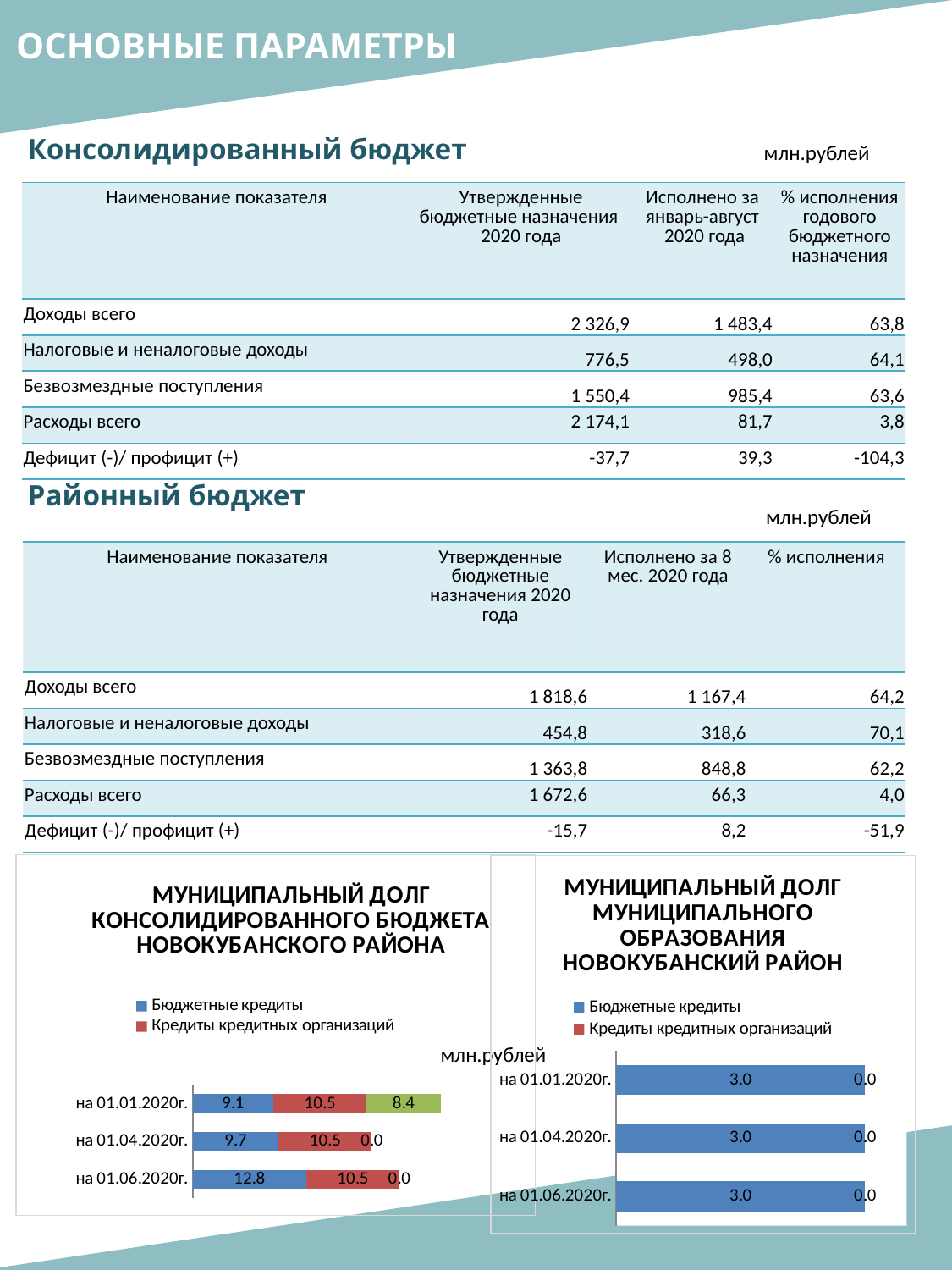
In the left chart (Муниципальный долг консолидированного бюджета Новокубанского района), what is the total of the stacked bar for на 01.06.2020г.? 23.3 In the right chart (Муниципальный долг муниципального образования Новокубанский район), what is the value of Бюджетные кредиты на 01.04.2020г.? 3.0 In the right chart (Муниципальный долг муниципального образования Новокубанский район), how many series does the legend list? 2 In the left chart (Муниципальный долг консолидированного бюджета Новокубанского района), what is the value of Бюджетные кредиты на 01.01.2020г.? 9.1 In the right chart (Муниципальный долг муниципального образования Новокубанский район), what is the value of Кредиты кредитных организаций на 01.06.2020г.? 0.0 In the left chart (Муниципальный долг консолидированного бюджета Новокубанского района), how many dates (categories) are shown? 3 What type of chart is the right chart (Муниципальный долг муниципального образования Новокубанский район)? bar chart In the left chart (Муниципальный долг консолидированного бюджета Новокубанского района), what is the value of Бюджетные кредиты на 01.06.2020г.? 12.8 In the left chart (Муниципальный долг консолидированного бюджета Новокубанского района), what is the difference between Бюджетные кредиты на 01.06.2020г. and на 01.01.2020г.? 3.7 In the left chart (Муниципальный долг консолидированного бюджета Новокубанского района), does the value of Бюджетные кредиты rise or fall from 01.01.2020 to 01.06.2020? rise In the left chart (Муниципальный долг консолидированного бюджета Новокубанского района), on which date is the value of Бюджетные кредиты the highest? на 01.06.2020г. In the left chart (Муниципальный долг консолидированного бюджета Новокубанского района), what is the value of Кредиты кредитных организаций на 01.04.2020г.? 10.5